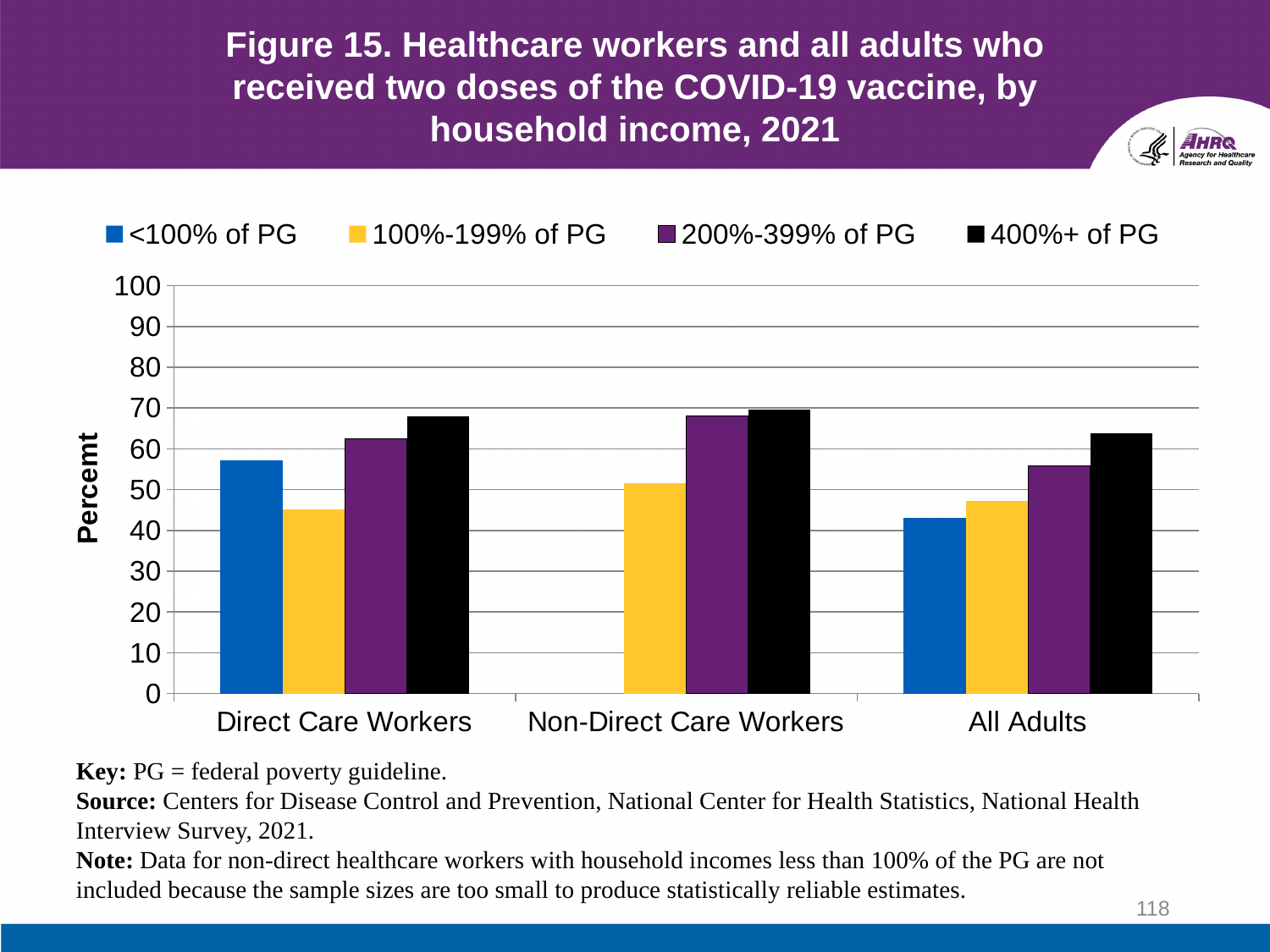
Among All Adults, which income group has the highest value? 400%+ of PG For Direct Care Workers, which is larger: the <100% of PG bar or the 100%-199% of PG bar? <100% of PG How many worker categories are shown on the x axis? 3 Is the value for Direct Care Workers with <100% of PG greater or less than 50? greater For the 200%-399% of PG group, which is larger: Direct Care Workers or All Adults? Direct Care Workers Among Direct Care Workers, which income group has the lowest value? 100%-199% of PG How many series does the legend list? 4 What kind of chart is shown on the slide? Bar chart Which category has no bar for <100% of PG? Non-Direct Care Workers For All Adults, do the values rise or fall as household income increases from <100% of PG to 400%+ of PG? rise Is the value for Non-Direct Care Workers with 400%+ of PG greater or less than 60? greater Is the value for All Adults with <100% of PG greater or less than 50? less